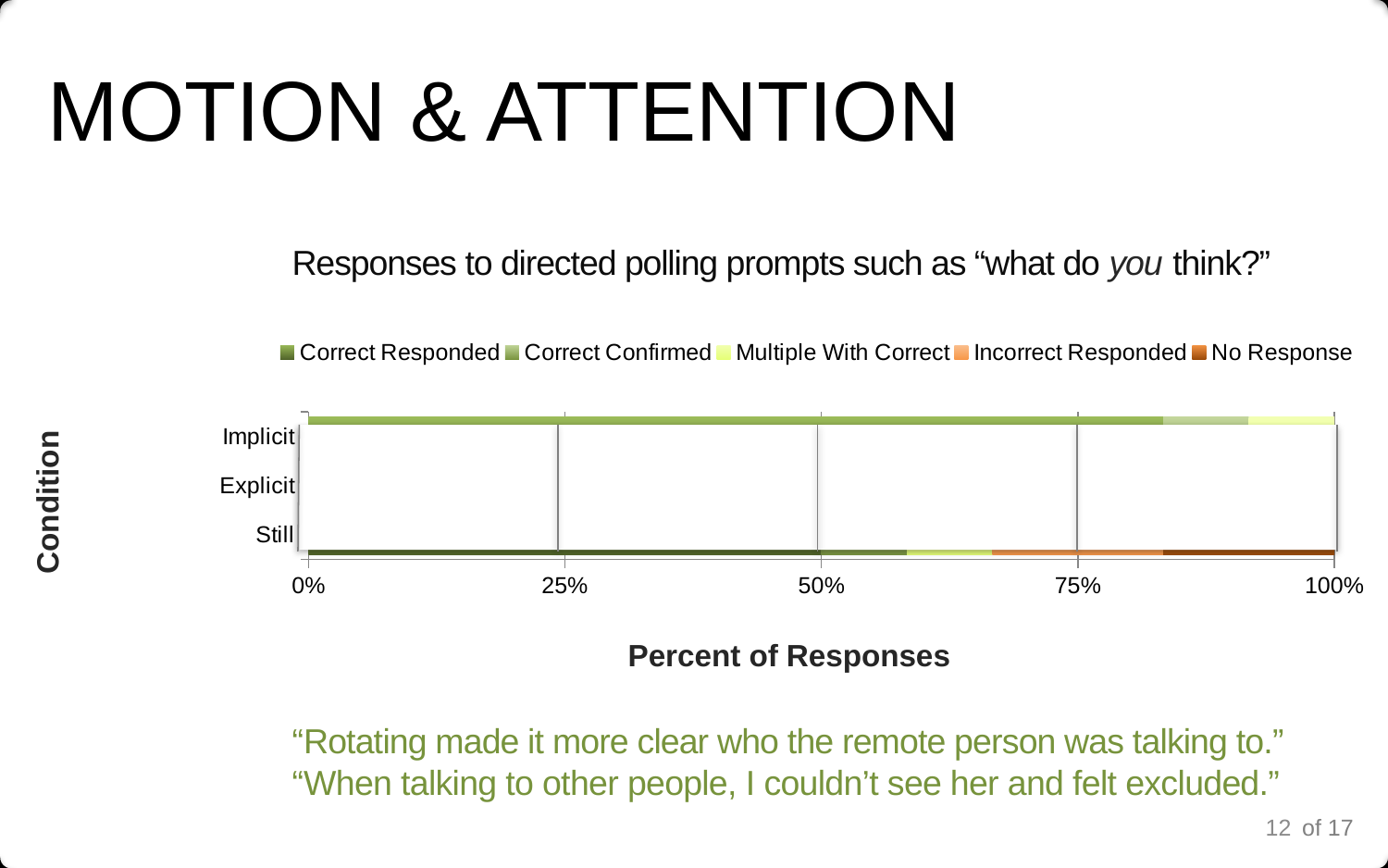
How many series does the legend list? 5 Which condition shows the largest No Response share? Still Which condition has the larger Correct Responded share, Implicit or Still? Implicit What is the title of the chart? Responses to directed polling prompts such as "what do you think?" Is the Correct Responded share for the Implicit condition greater or less than 75%? greater What is the label of the x axis? Percent of Responses Is the Correct Responded share for the Still condition greater or less than 75%? less What kind of chart is shown on the slide? Stacked horizontal bar chart How many conditions are shown on the y axis of the chart? 3 Which condition shows the largest Incorrect Responded share? Still